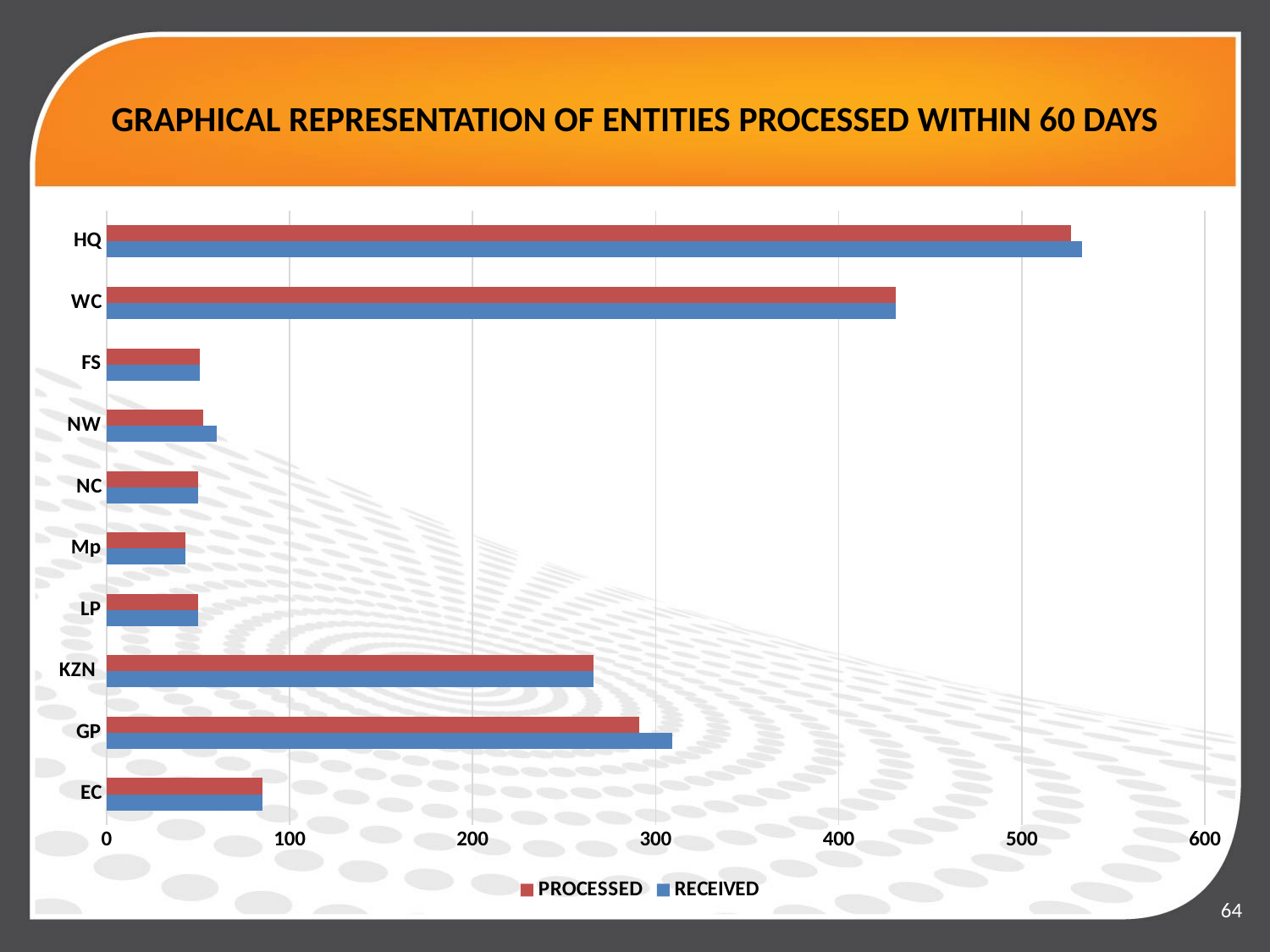
What kind of chart is shown on the slide? Bar chart Which colour represents the PROCESSED series in the legend? Red Which category has the highest RECEIVED value? HQ How many categories are shown on the vertical axis of the chart? 10 Is the RECEIVED value for HQ greater or less than 500? greater Is the PROCESSED value for EC greater or less than 100? less Which category has the highest PROCESSED value? HQ Which has the larger RECEIVED value, GP or KZN? GP How many series does the chart's legend list? 2 Is the RECEIVED value for KZN greater or less than 300? less Which has the larger PROCESSED value, EC or KZN? KZN